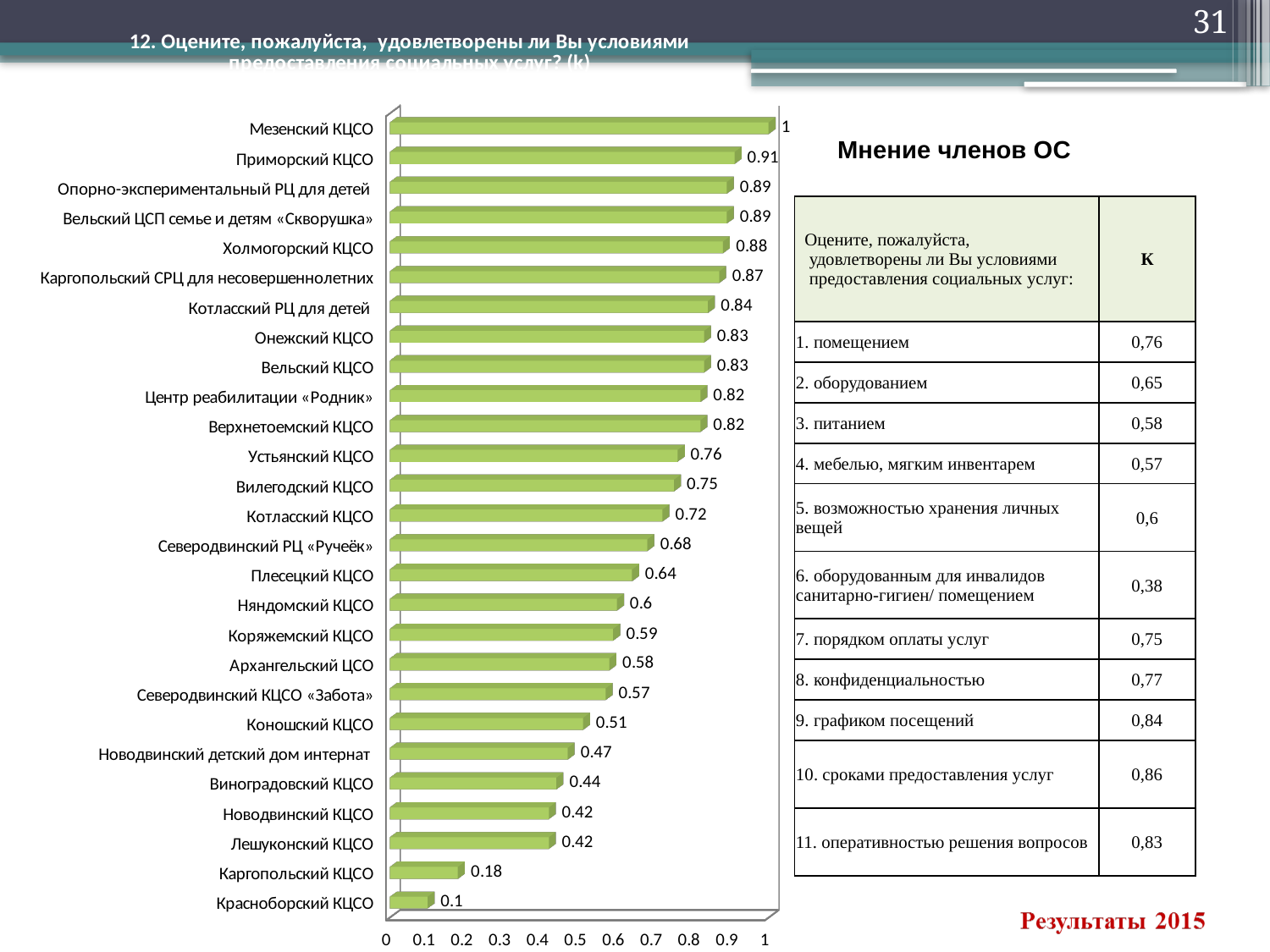
What is the difference between the values for Устьянский КЦСО and Котласский КЦСО? 0.04 Which has a larger value, Плесецкий КЦСО or Виноградовский КЦСО? Плесецкий КЦСО Which category has the lowest value? Красноборский КЦСО What is the value for Мезенский КЦСО? 1 What is the value for Каргопольский КЦСО? 0.18 Is the value for Холмогорский КЦСО greater or less than 0.8? greater What is the difference between the values for Мезенский КЦСО and Красноборский КЦСО? 0.9 What is the value for Приморский КЦСО? 0.91 What kind of chart is shown on the slide? bar chart Which category has the highest value? Мезенский КЦСО What is the value for Коношский КЦСО? 0.51 How many categories are shown in the chart? 27